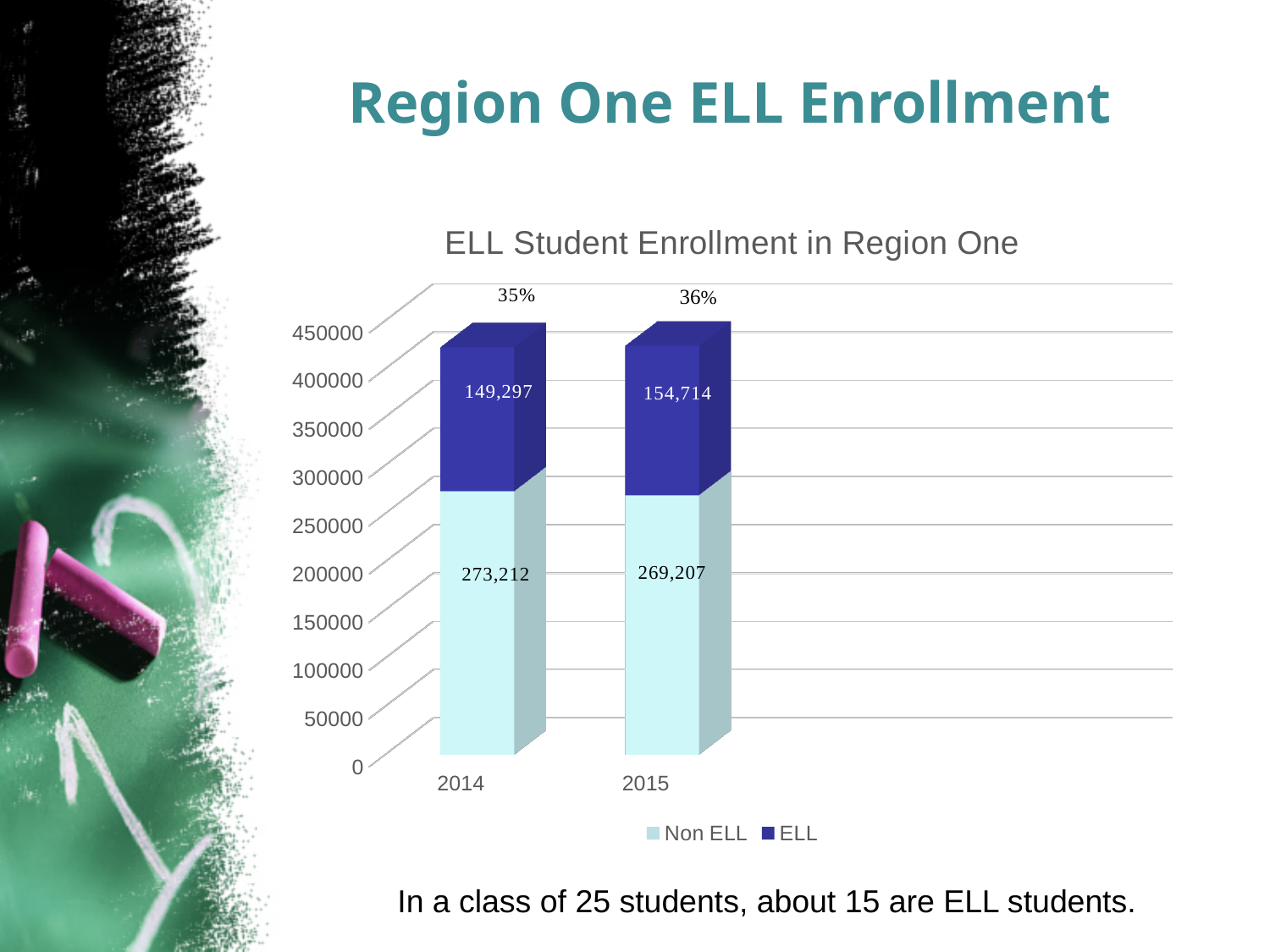
How many series does the legend list? 2 Which year has the higher ELL enrollment, 2014 or 2015? 2015 What is the Non ELL enrollment for 2014? 273,212 By how much did ELL enrollment increase from 2014 to 2015? 5,417 What is the total enrollment (Non ELL plus ELL) for 2014? 422,509 What percentage label is shown above the 2015 bar? 36% What is the ELL enrollment for 2015? 154,714 What is the difference between Non ELL enrollment in 2014 and 2015? 4,005 What type of chart is shown on the slide? Stacked bar chart How many years are shown on the x axis? 2 What is the ELL enrollment for 2014? 149,297 Which year has the lower Non ELL enrollment? 2015